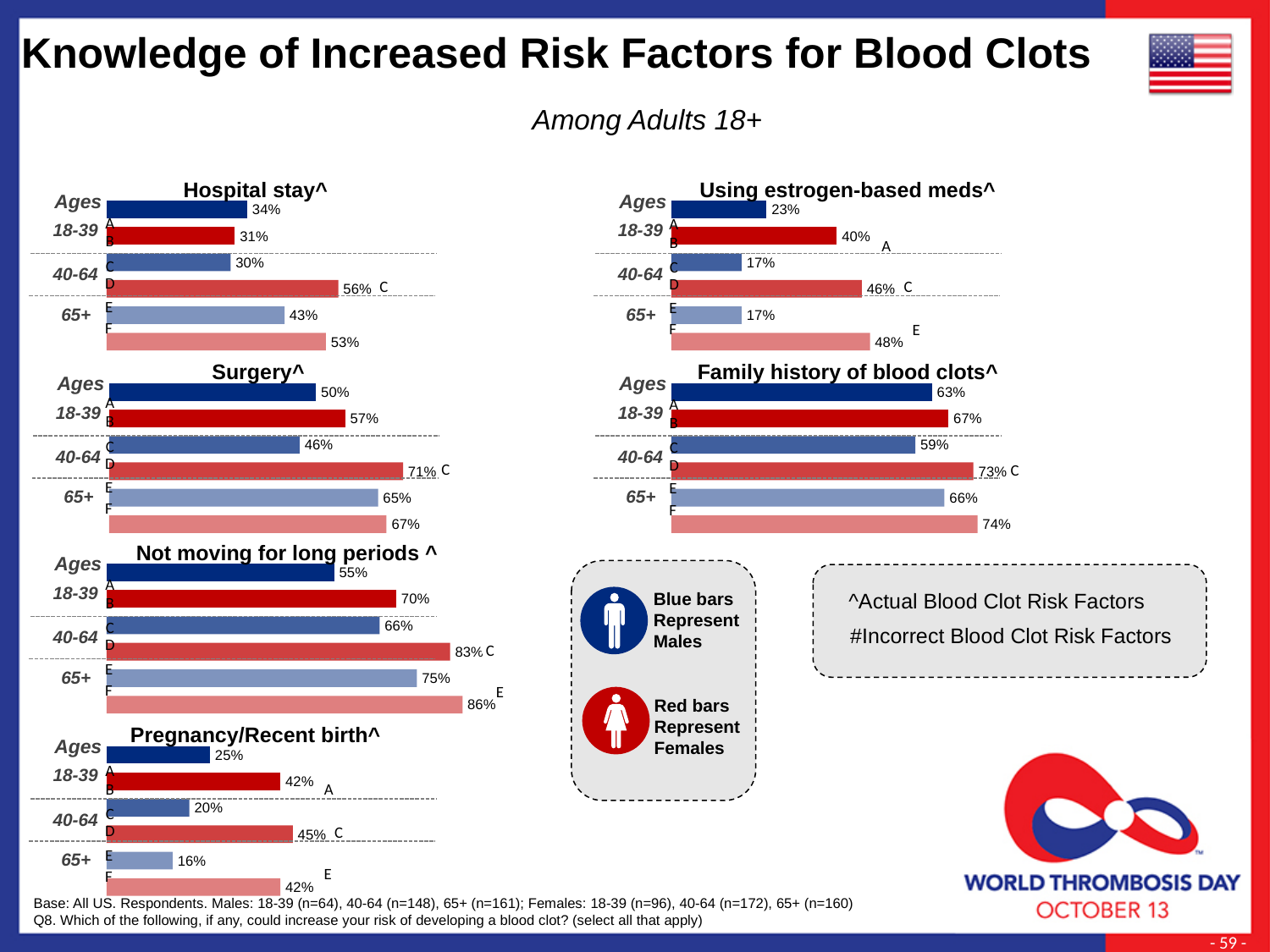
According to the legend on the slide, what do the red bars represent? Females In the 'Surgery' chart, what is the difference between females and males aged 40-64? 25 percentage points In the 'Hospital stay' chart, what is the value for males aged 18-39? 34% In the 'Hospital stay' chart, what percentage of females aged 40-64 identified hospital stay as a risk factor? 56% In the 'Not moving for long periods' chart, which age and gender group has the highest value? Females 65+ (86%) In the 'Pregnancy/Recent birth' chart, which group has the lowest value? Males 65+ (16%) How many age groups are shown in each chart on the slide? 3 In the 'Not moving for long periods' chart, do the values for males rise or fall as age increases from 18-39 to 65+? Rise What type of chart is used for 'Family history of blood clots'? Bar chart In the 'Using estrogen-based meds' chart, what is the difference between females and males aged 65+? 31 percentage points In the 'Family history of blood clots' chart, which is larger: the value for males aged 18-39 or males aged 40-64? Males aged 18-39 (63%) In the 'Surgery' chart, what is the value for males aged 65+? 65%